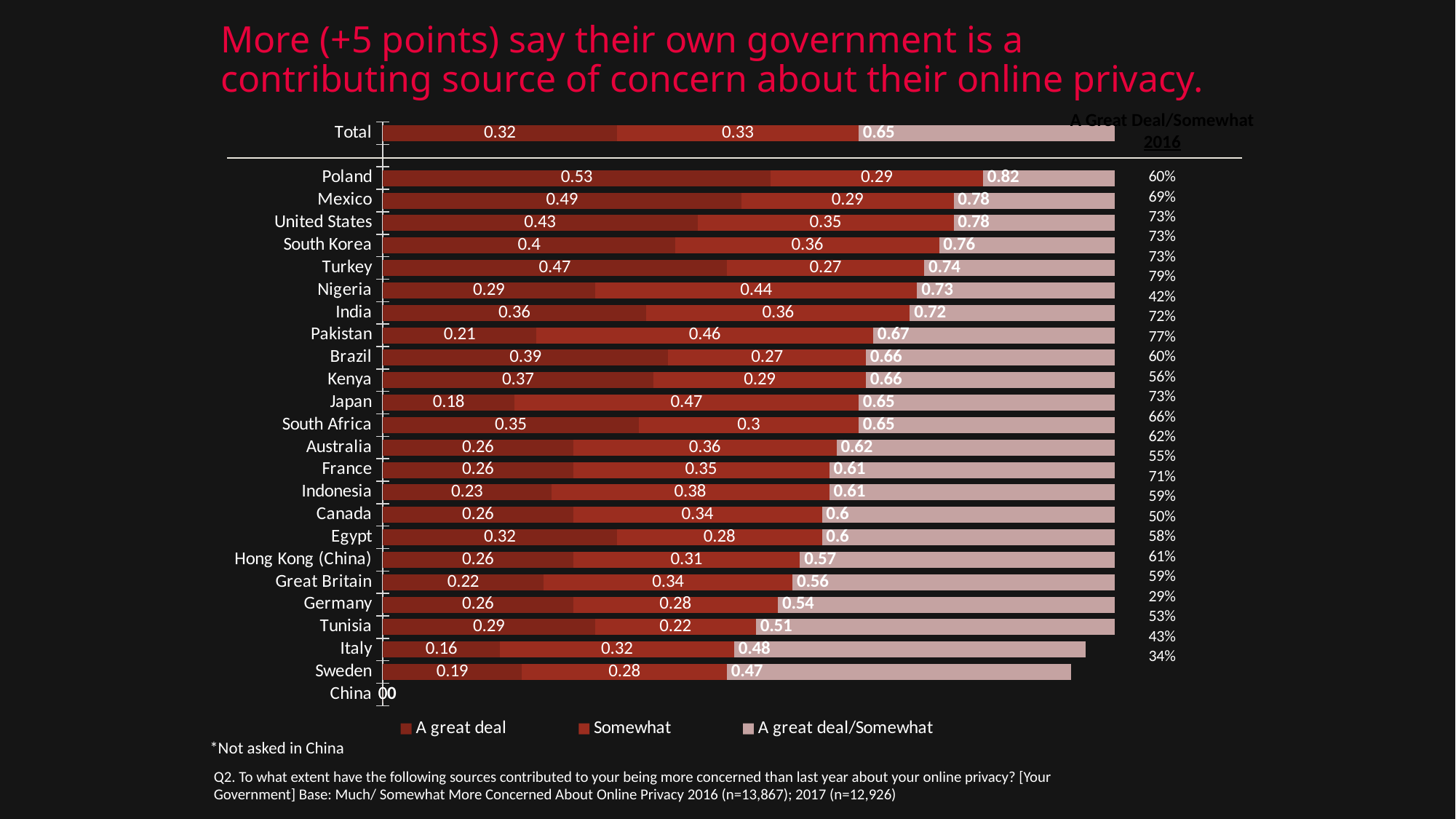
What kind of chart is shown on the slide? Bar chart What is the difference between the 'Somewhat' and 'A great deal' values for Nigeria? 0.15 What is the 'A great deal/Somewhat' value for the Total row? 0.65 What is the difference between the 'A great deal/Somewhat' values for Poland and Sweden? 0.35 How many series does the legend list? 3 Which country has the lowest 'A great deal' value? Italy How many countries are listed on the chart's axis (excluding Total)? 24 According to the footnote, which country was the question not asked in? China Which has the larger 'A great deal' value, Mexico or the United States? Mexico What is the 'A great deal' value for Poland? 0.53 Which country has the highest 'A great deal/Somewhat' value? Poland What is the 'Somewhat' value for Japan? 0.47